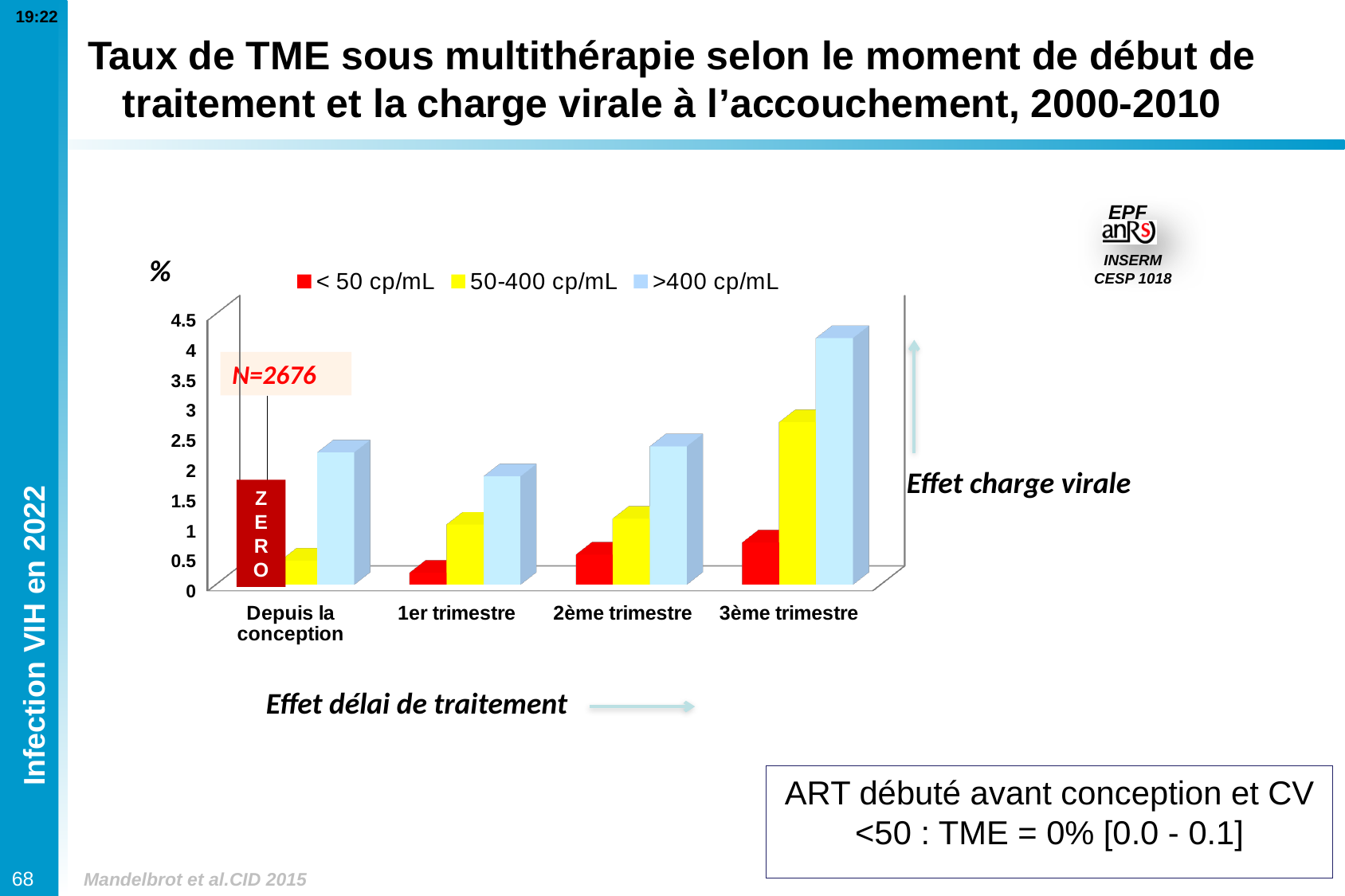
How many series does the legend list? 3 What is the TME rate for < 50 cp/mL when treatment started 'Depuis la conception'? 0% Which category has the highest value for the 50-400 cp/mL series? 3ème trimestre Is the value for >400 cp/mL in the 3ème trimestre greater or less than 3? greater In the 3ème trimestre, which is larger: the >400 cp/mL value or the 50-400 cp/mL value? >400 cp/mL Is the value for 50-400 cp/mL in the 1er trimestre greater or less than 2? less Which category has the highest value for the >400 cp/mL series? 3ème trimestre What kind of chart is shown on the slide? bar chart Do the values for the < 50 cp/mL series rise or fall from 'Depuis la conception' to '3ème trimestre'? rise How many categories are shown on the x axis? 4 Which category has the lowest value for the < 50 cp/mL series? Depuis la conception What sample size (N) is shown on the chart? N=2676